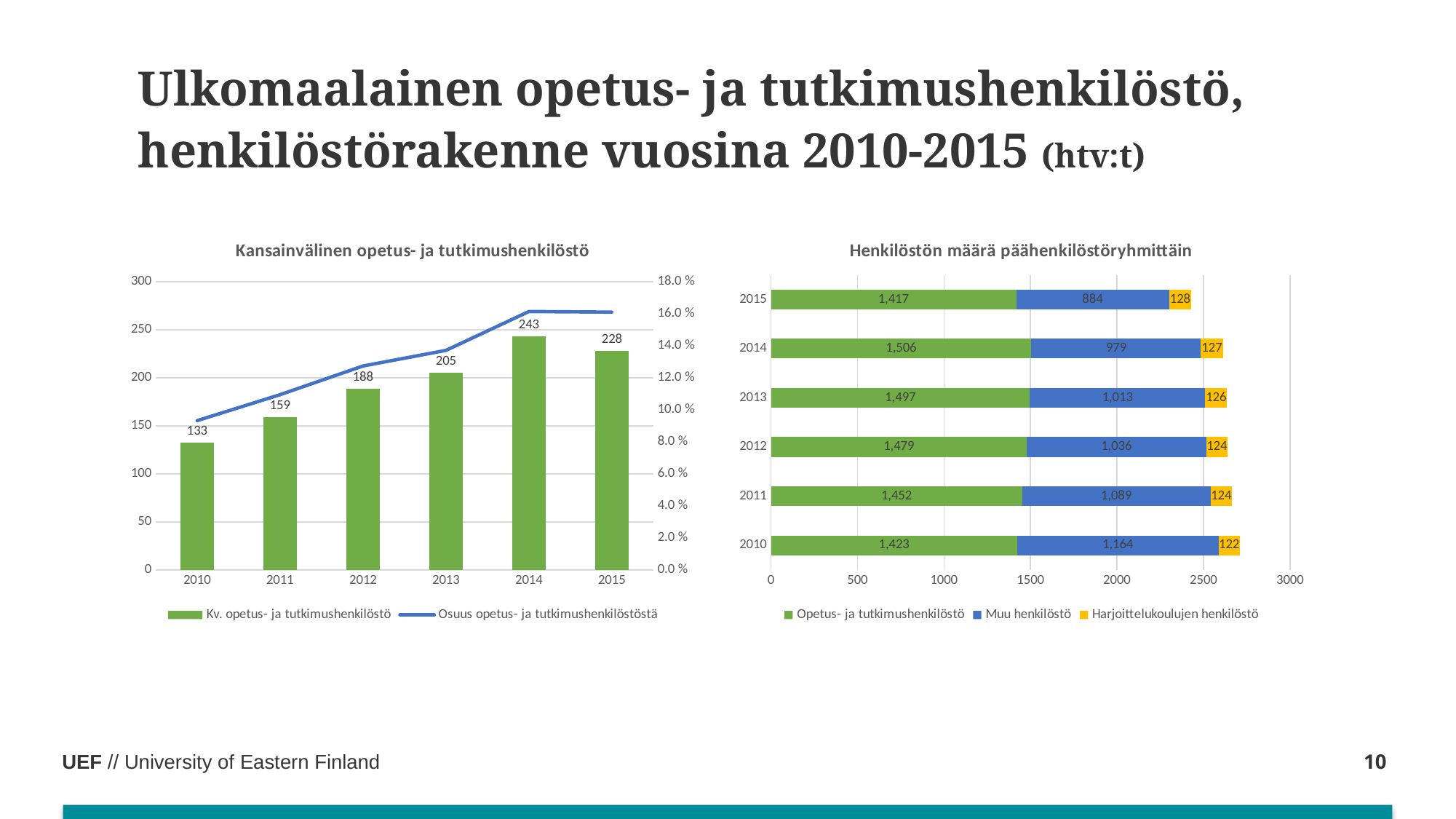
In the chart titled "Henkilöstön määrä päähenkilöstöryhmittäin", what is the total of the stacked bar for 2015? 2,429 In the chart titled "Kansainvälinen opetus- ja tutkimushenkilöstö", which year has the highest bar? 2014 In the chart titled "Henkilöstön määrä päähenkilöstöryhmittäin", does the Muu henkilöstö value rise or fall from 2010 to 2015? Fall How many series does the legend of the chart titled "Kansainvälinen opetus- ja tutkimushenkilöstö" list? 2 In the chart titled "Kansainvälinen opetus- ja tutkimushenkilöstö", what is the value of Kv. opetus- ja tutkimushenkilöstö for 2014? 243 In the chart titled "Kansainvälinen opetus- ja tutkimushenkilöstö", is the value of the Osuus opetus- ja tutkimushenkilöstöstä line for 2015 greater or less than 14.0 %? greater In the chart titled "Kansainvälinen opetus- ja tutkimushenkilöstö", by how much did the bar value fall from 2014 to 2015? 15 In the chart titled "Henkilöstön määrä päähenkilöstöryhmittäin", which year has the larger Muu henkilöstö value, 2011 or 2012? 2011 How many years are shown in the chart titled "Henkilöstön määrä päähenkilöstöryhmittäin"? 6 What kind of chart is the chart titled "Henkilöstön määrä päähenkilöstöryhmittäin"? Stacked bar chart In the chart titled "Kansainvälinen opetus- ja tutkimushenkilöstö", which year has the lowest bar? 2010 In the chart titled "Henkilöstön määrä päähenkilöstöryhmittäin", what is the value of Muu henkilöstö for 2010? 1,164